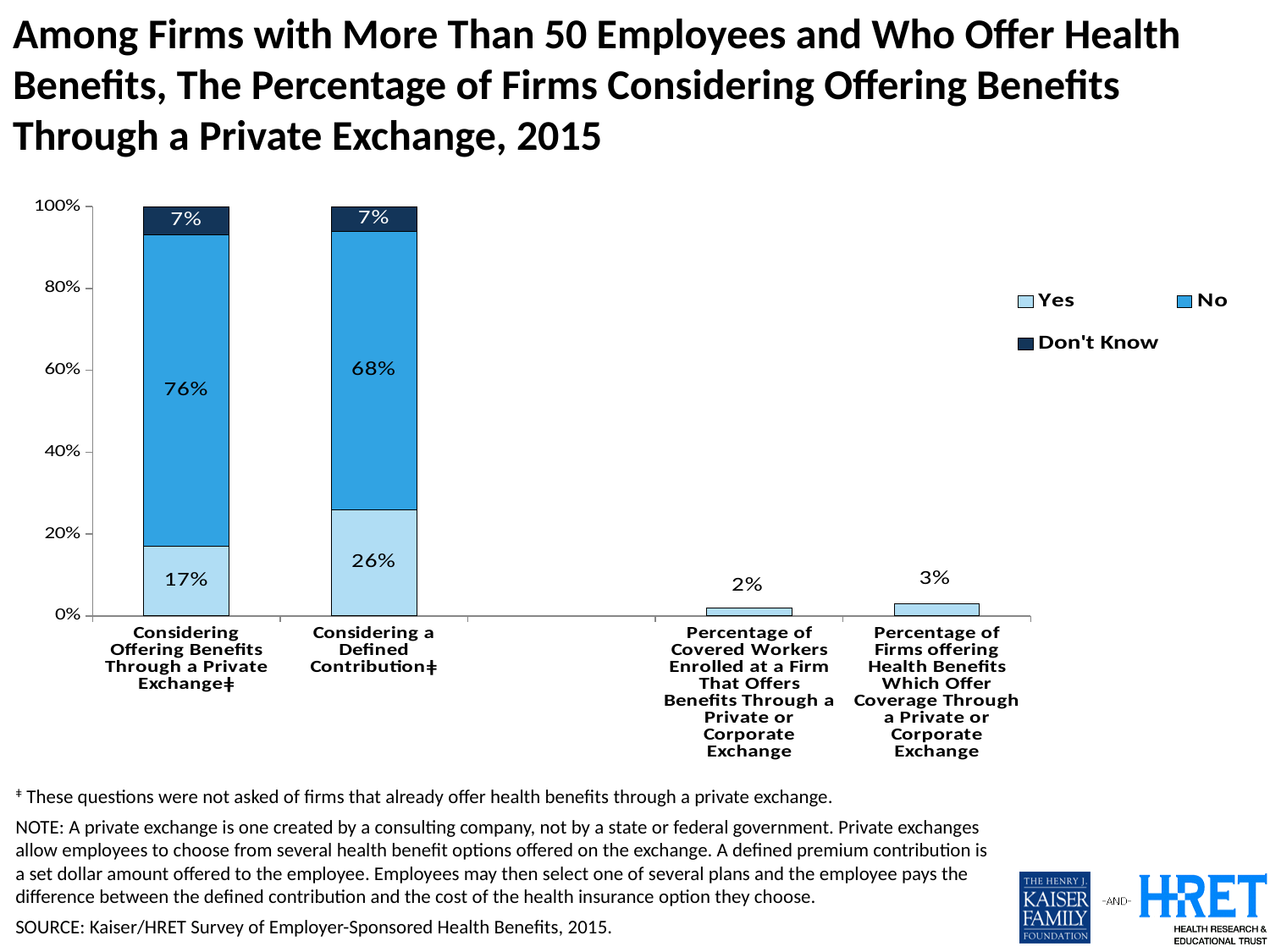
How many series does the legend list? 3 Which category has the highest "Yes" value? Considering a Defined Contribution Which legend entry is shown in the darkest colour? Don't Know Which is larger: the "No" value for "Considering Offering Benefits Through a Private Exchange" or the "No" value for "Considering a Defined Contribution"? Considering Offering Benefits Through a Private Exchange What is the "Don't Know" value for the "Considering Offering Benefits Through a Private Exchange" bar? 7% What percentage of firms answered "Yes" to considering offering benefits through a private exchange? 17% What is the value shown for "Percentage of Firms offering Health Benefits Which Offer Coverage Through a Private or Corporate Exchange"? 3% What is the value shown for "Percentage of Covered Workers Enrolled at a Firm That Offers Benefits Through a Private or Corporate Exchange"? 2% How many categories are shown on the x axis? 4 What is the difference between the "Yes" values for "Considering a Defined Contribution" and "Considering Offering Benefits Through a Private Exchange"? 9% What kind of chart is shown on the slide? Stacked bar chart What percentage of firms answered "No" to considering a defined contribution? 68%